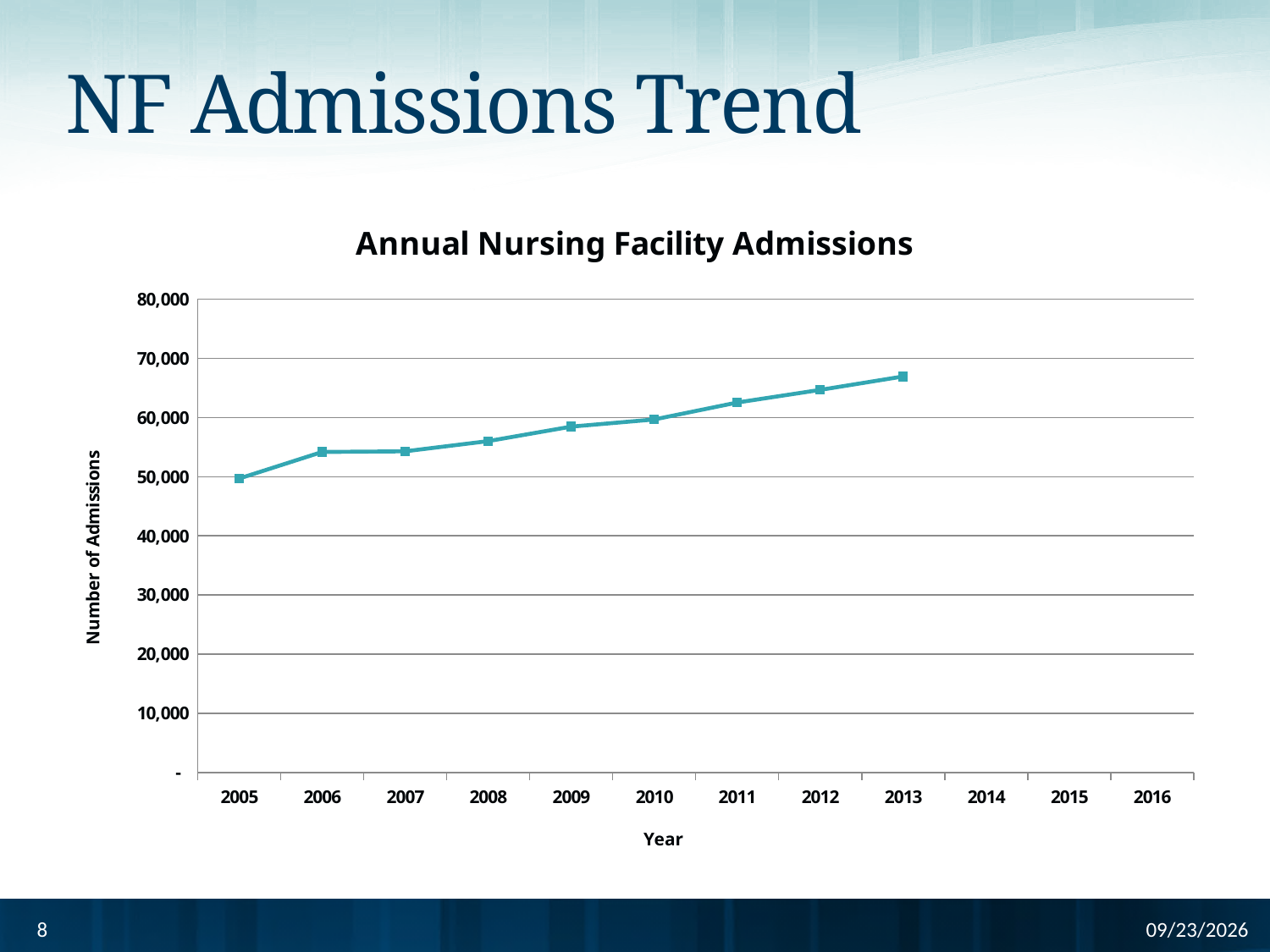
Is the value for 2008 greater or less than 60,000? less How many years have a plotted data point on the line? 9 Is the value for 2006 greater or less than 50,000? greater What kind of chart is shown on the slide? line chart What is the title of the chart? Annual Nursing Facility Admissions Which year has more admissions, 2005 or 2013? 2013 Is the value for 2013 greater or less than 70,000? less Do admissions generally rise or fall from 2005 to 2013? rise Which year has the highest number of admissions? 2013 Which year has the lowest number of admissions? 2005 What is the label on the vertical axis of the chart? Number of Admissions